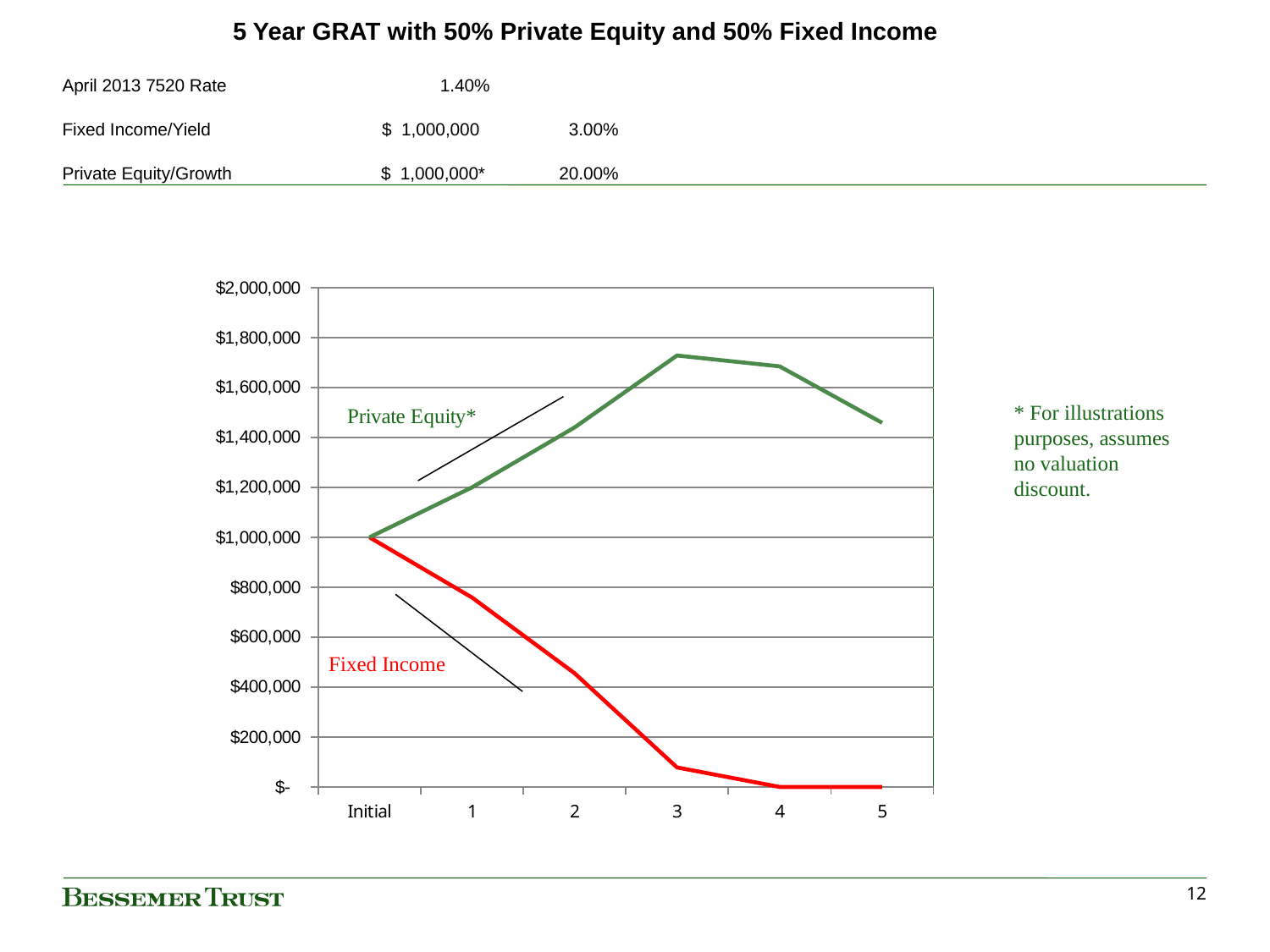
What kind of chart is shown on the slide? line chart How many series are plotted on the chart? 2 Does the Fixed Income line rise or fall from Initial to 5? fall Is the value for Fixed Income at point 2 greater or less than $600,000? less Is the value for Private Equity* at point 5 greater or less than $1,400,000? greater Which series has the larger value at point 4, Private Equity* or Fixed Income? Private Equity* At which x-axis point does Private Equity* reach its highest value? 3 What colour is the Fixed Income line? red What is the value of Fixed Income at the Initial point? $1,000,000 What is the value of Private Equity* at the Initial point? $1,000,000 Is the value for Private Equity* at point 3 greater or less than $1,600,000? greater How many points are plotted along the x axis for each series? 6